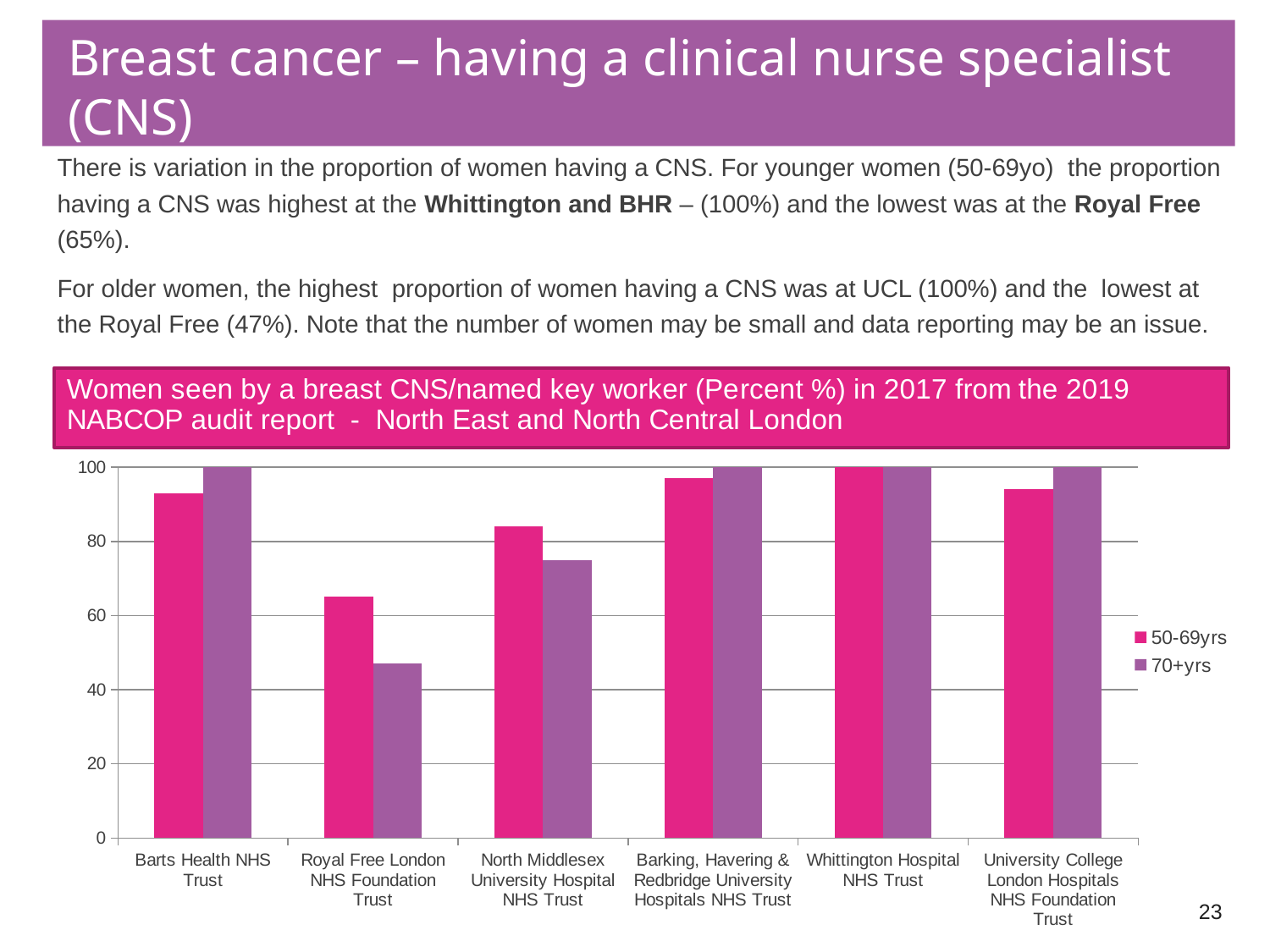
What kind of chart is shown on the slide? Bar chart What is the value for Whittington Hospital NHS Trust in the 50-69yrs series? 100 For Barts Health NHS Trust, which series has the larger value, 50-69yrs or 70+yrs? 70+yrs How many trusts are shown on the x axis of the chart? 6 Which trust has the lowest value in the 50-69yrs series? Royal Free London NHS Foundation Trust What colour represents the 70+yrs series in the chart? Purple How many series does the legend list? 2 What is the value for University College London Hospitals NHS Foundation Trust in the 70+yrs series? 100 Is the value for Barts Health NHS Trust in the 50-69yrs series greater or less than 80? greater For North Middlesex University Hospital NHS Trust, which series has the larger value, 50-69yrs or 70+yrs? 50-69yrs Is the value for North Middlesex University Hospital NHS Trust in the 70+yrs series greater or less than 80? less Which trust has the lowest value in the 70+yrs series? Royal Free London NHS Foundation Trust